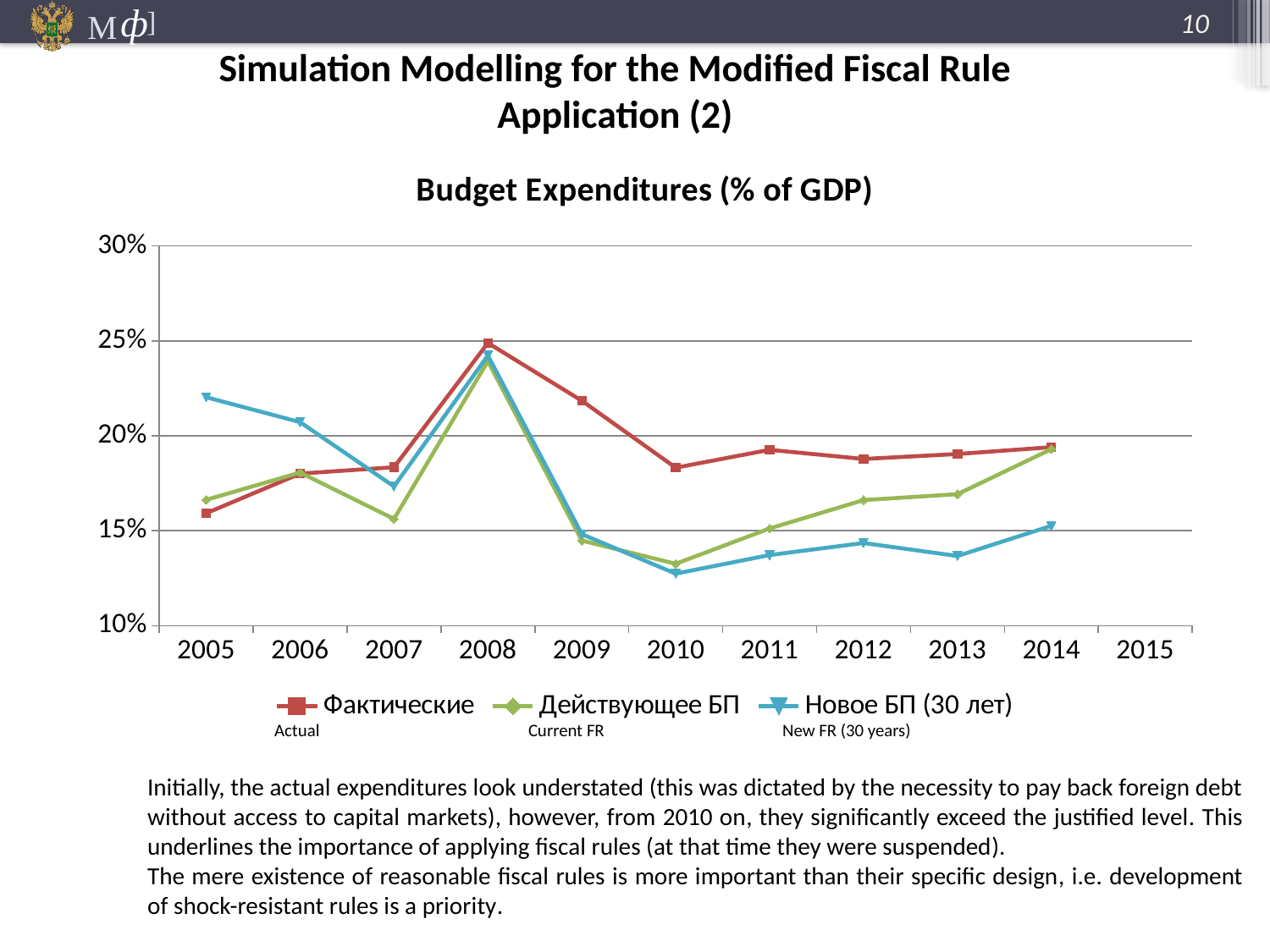
In 2005, which series has the larger value: Новое БП (30 лет) (New FR) or Фактические (Actual)? Новое БП (30 лет) (New FR) Which colour is used for the Фактические (Actual) series? Red Is the value for Новое БП (30 лет) (New FR) in 2010 greater or less than 15%? less Does the Фактические (Actual) series rise or fall from 2008 to 2010? Fall What is the title of the chart? Budget Expenditures (% of GDP) How many series does the chart legend list? 3 Is the value for Фактические (Actual) in 2008 greater or less than 20%? greater What kind of chart is shown on the slide? Line chart In 2012, which series has the larger value: Фактические (Actual) or Новое БП (30 лет) (New FR)? Фактические (Actual) In which year does the Фактические (Actual) series reach its highest value? 2008 In which year does the Новое БП (30 лет) (New FR) series reach its lowest value? 2010 Is the value for Фактические (Actual) in 2012 greater or less than 20%? less